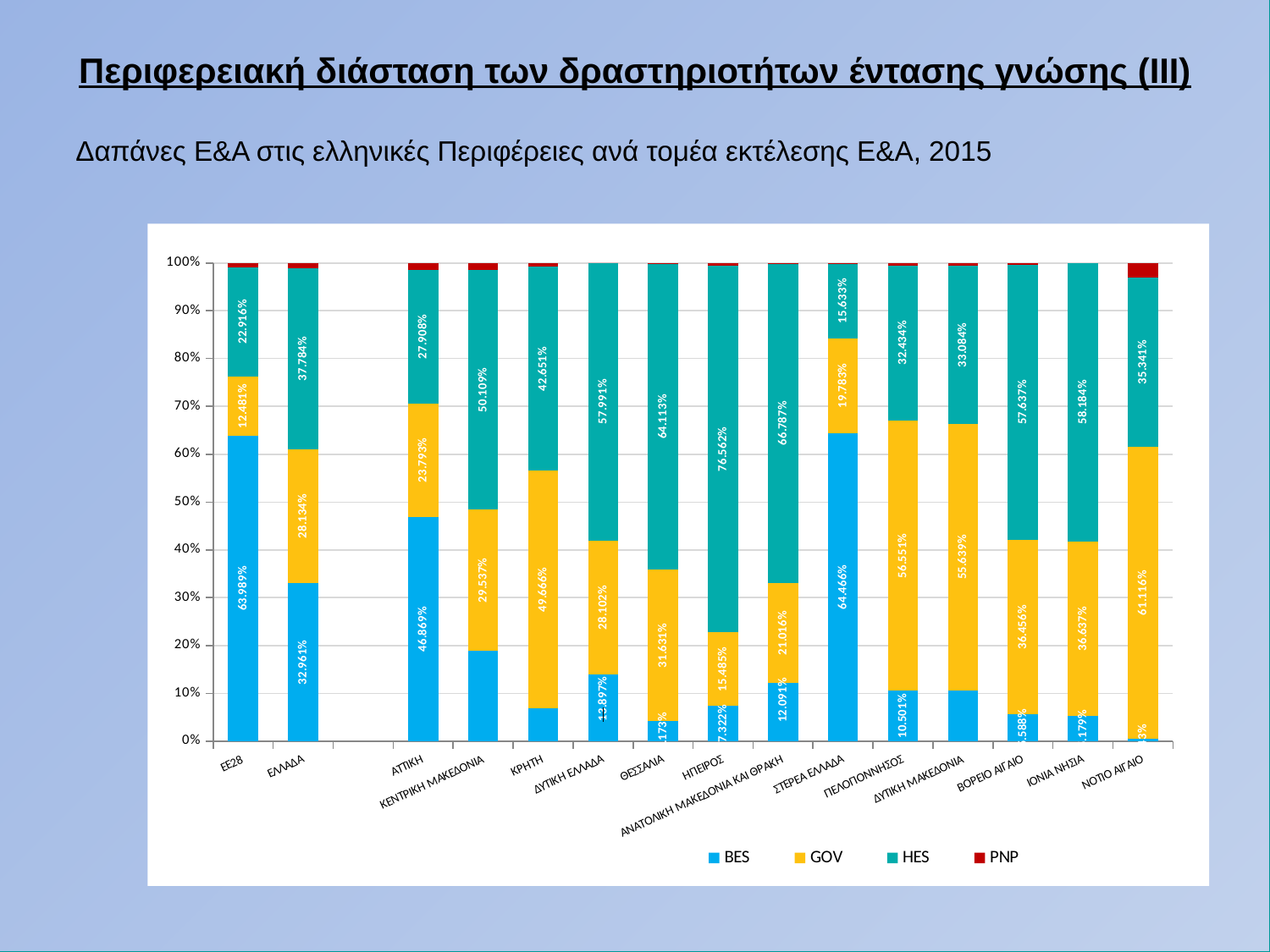
Which category has the highest GOV share? ΝΟΤΙΟ ΑΙΓΑΙΟ What type of chart is shown on the slide? Stacked bar chart Which series is shown in red in the legend? PNP Which is larger, the GOV value for ΚΡΗΤΗ or the GOV value for ΑΤΤΙΚΗ? ΚΡΗΤΗ How many series does the legend list? 4 Which category has the highest HES share? ΗΠΕΙΡΟΣ What is the HES value for ΗΠΕΙΡΟΣ? 76.562% What is the GOV value for ΠΕΛΟΠΟΝΝΗΣΟΣ? 56.551% What is the difference between the HES value for ΕΛΛΑΔΑ and the HES value for ΕΕ28? 14.868% Is the BES value for ΚΕΝΤΡΙΚΗ ΜΑΚΕΔΟΝΙΑ greater or less than 30%? less What is the BES value for ΣΤΕΡΕΑ ΕΛΛΑΔΑ? 64.466% What is the BES value for ΕΕ28? 63.989%